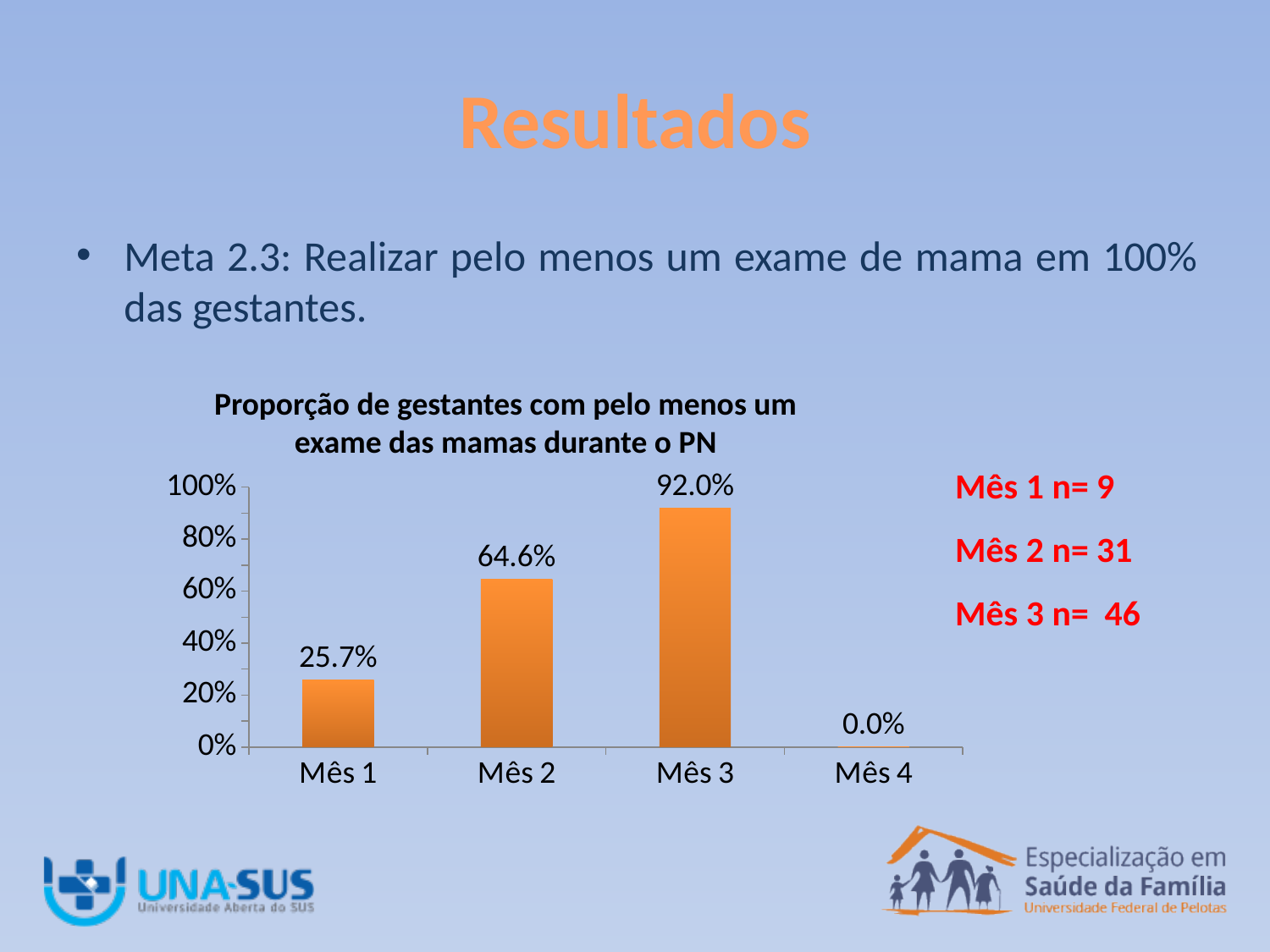
What is the value for Mês 4? 0.0% Is the value for Mês 3 greater or less than 80%? greater What is the title of the chart? Proporção de gestantes com pelo menos um exame das mamas durante o PN What kind of chart is shown? bar chart Which is larger, the value for Mês 1 or the value for Mês 2? Mês 2 What is the value for Mês 3? 92.0% Which month has the highest value? Mês 3 What is the value for Mês 1? 25.7% What is the value for Mês 2? 64.6% How many months are shown on the x axis? 4 What is the difference between the values for Mês 3 and Mês 2? 27.4% Which month has the lowest value? Mês 4